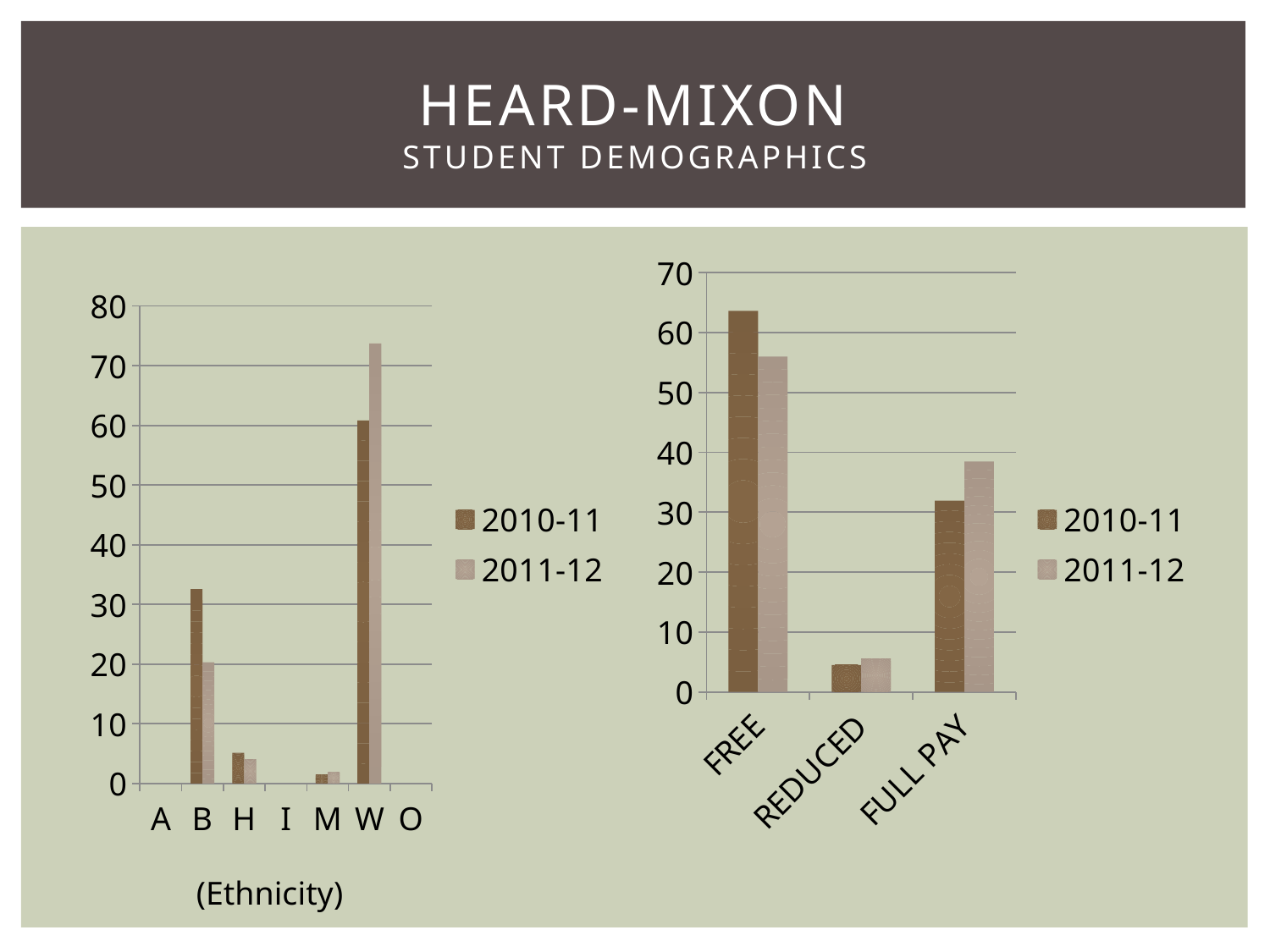
In the chart on the right, is the 2010-11 value for FREE greater or less than 60? greater What kind of chart is the Ethnicity chart on the left? bar chart In the chart on the right, which category has the lowest value for 2011-12? REDUCED In the Ethnicity chart on the left, is the 2011-12 value for W greater or less than 70? greater In the chart on the right, which category has the highest value for 2010-11? FREE In the chart on the right, which is larger for FULL PAY: the 2010-11 value or the 2011-12 value? 2011-12 What are the two legend entries in the chart on the right? 2010-11 and 2011-12 In the Ethnicity chart on the left, which category has the highest value for 2011-12? W In the Ethnicity chart on the left, is the 2010-11 value for B greater or less than 30? greater In the Ethnicity chart on the left, which is larger for category B: the 2010-11 value or the 2011-12 value? 2010-11 How many categories are shown on the x axis of the Ethnicity chart on the left? 7 How many series does the legend of the Ethnicity chart on the left list? 2